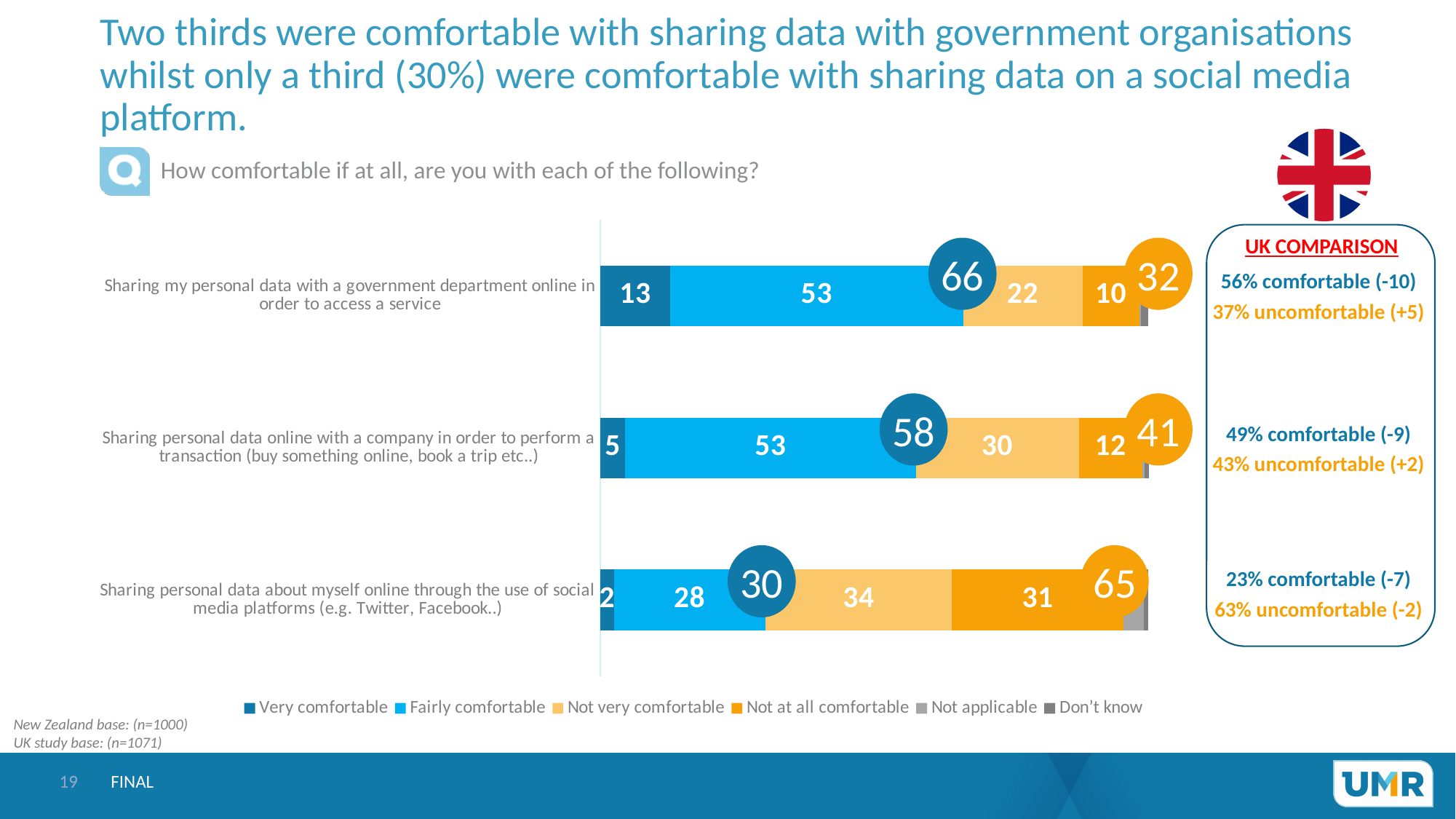
What total comfortable figure is shown in the circle for sharing personal data online with a company in order to perform a transaction? 58 What is the 'Not very comfortable' value for sharing personal data online with a company in order to perform a transaction? 30 What is the 'Not at all comfortable' value for sharing personal data about myself online through the use of social media platforms? 31 How many series does the legend list? 6 What colour represents the 'Not at all comfortable' series in the legend? Orange What is the 'Very comfortable' value for sharing personal data with a government department online in order to access a service? 13 What kind of chart is shown on the slide? Stacked bar chart How many categories (statements) are plotted in the chart? 3 Which is larger: the 'Not very comfortable' value for the government department category or for the social media platforms category? Social media platforms (34) What is the difference between the 'Not at all comfortable' values for the social media platforms category and the government department category? 21 Which category has the lowest 'Fairly comfortable' value? Sharing personal data about myself online through the use of social media platforms Which category has the highest 'Very comfortable' value? Sharing my personal data with a government department online in order to access a service